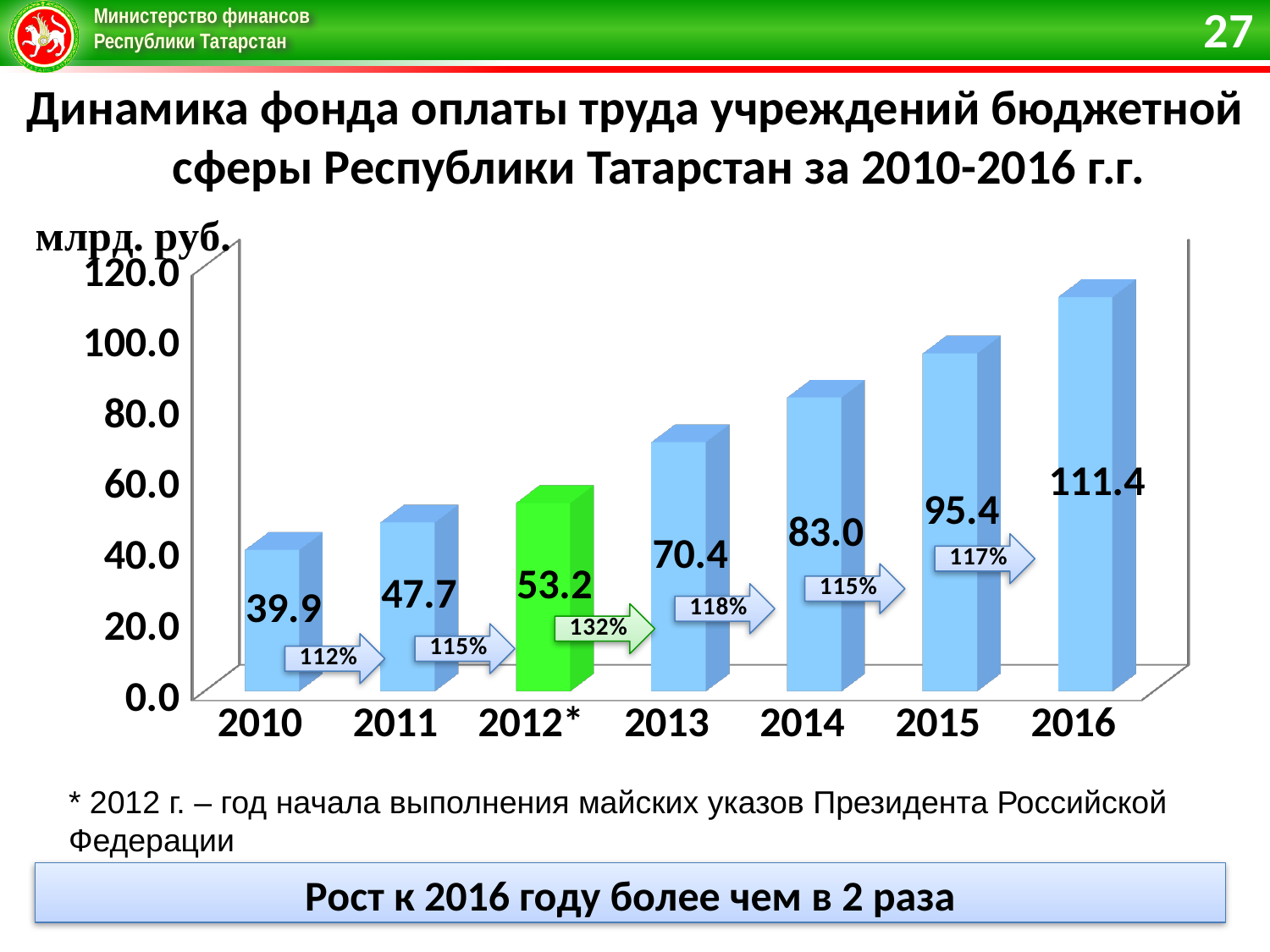
Which year has the highest value? 2016 What growth percentage is shown on the arrow between 2012* and 2013? 132% Which year has the lowest value? 2010 Which is larger, the value for 2015 or the value for 2013? 2015 Do the values rise or fall from 2010 to 2016? rise What is the value for 2016? 111.4 What is the value for 2010? 39.9 What is the value for 2014? 83.0 What is the difference between the values for 2013 and 2012*? 17.2 How many years are shown on the x axis? 7 What kind of chart is shown on the slide? bar chart What is the difference between the values for 2016 and 2010? 71.5